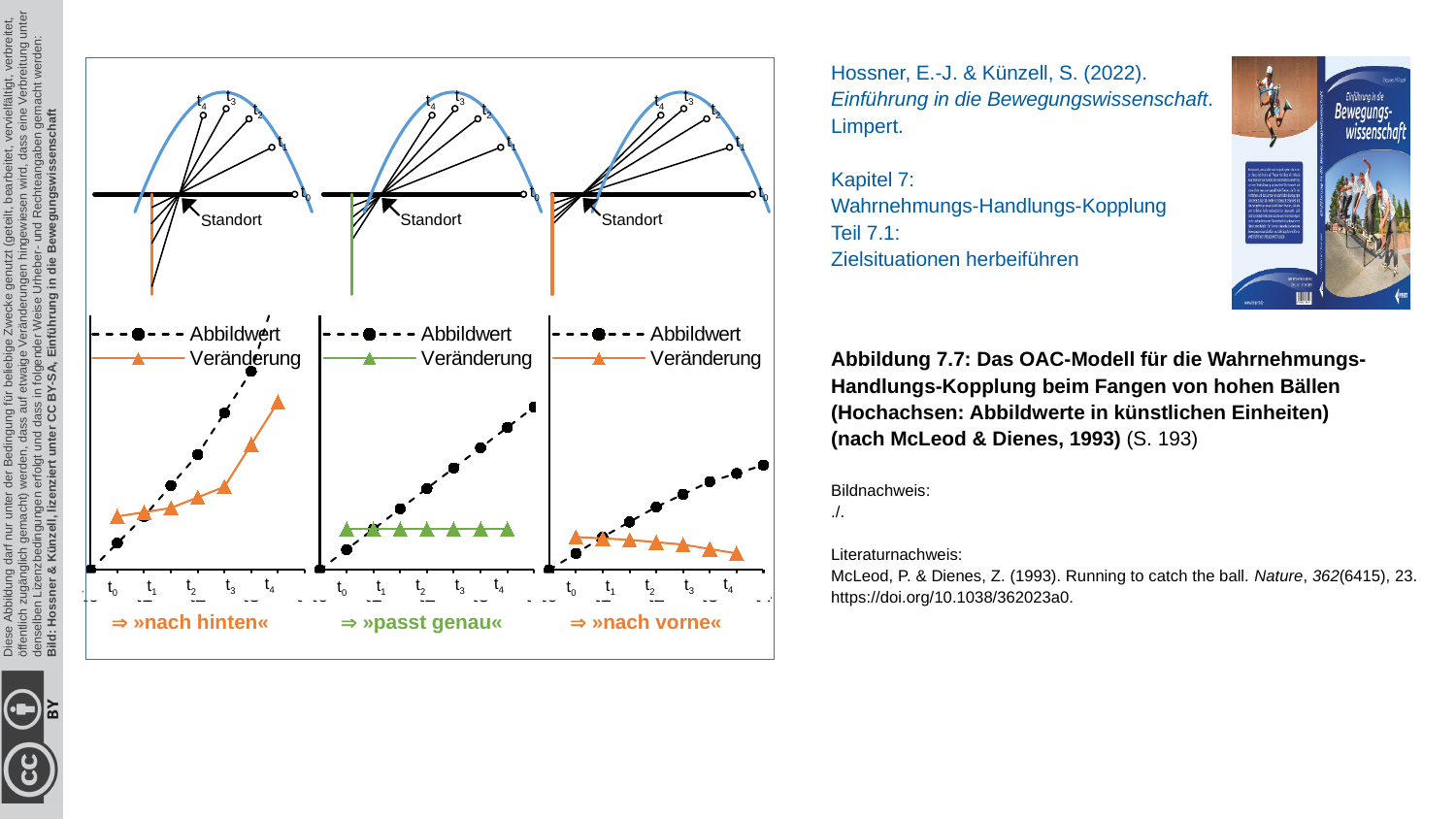
How many series does the legend of the »passt genau« chart list? 2 In the »nach hinten« chart, does the Abbildwert series rise or fall from t0 to t4? rise How many line charts with legends are shown in the bottom row of the slide? 3 What kind of chart is shown in the bottom-left panel labelled »nach hinten«? line chart In the »nach hinten« chart, does the Veränderung series rise or fall from t0 to t4? rise How many time points are marked on the x axis of the »nach vorne« chart? 5 In the »nach vorne« chart, does the Veränderung series rise or fall from t0 to t4? fall In the »nach hinten« chart, which series is higher at t4, Abbildwert or Veränderung? Abbildwert In the »nach vorne« chart, which series is higher at t4, Abbildwert or Veränderung? Abbildwert What are the two legend entries in the »nach vorne« chart? Abbildwert, Veränderung What colour is the Veränderung series in the »passt genau« chart? green